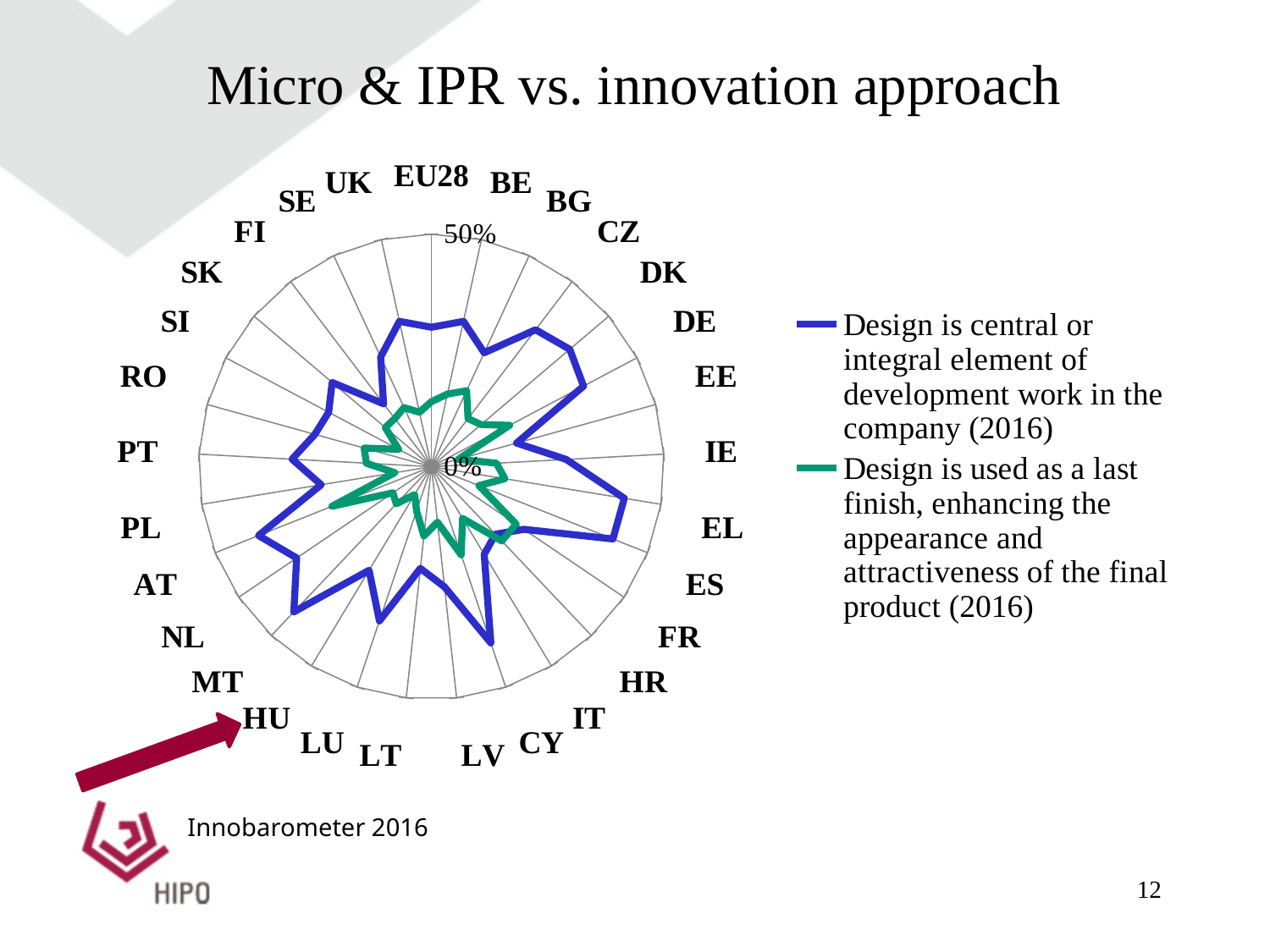
Which colour represents the series 'Design is central or integral element of development work in the company (2016)'? Blue For EU28, which series has the larger value: 'Design is central or integral element of development work in the company (2016)' or 'Design is used as a last finish, enhancing the appearance and attractiveness of the final product (2016)'? Design is central or integral element of development work in the company (2016) Is the value for EL in the series 'Design is used as a last finish, enhancing the appearance and attractiveness of the final product (2016)' greater or less than 50%? less Is the value for EU28 in the series 'Design is central or integral element of development work in the company (2016)' greater or less than 50%? less What is the maximum value shown on the chart's radial axis? 50% How many series does the chart's legend list? 2 What is the title of the slide containing the chart? Micro & IPR vs. innovation approach What kind of chart is shown on the slide? Radar chart For EL, which series has the larger value: 'Design is central or integral element of development work in the company (2016)' or 'Design is used as a last finish, enhancing the appearance and attractiveness of the final product (2016)'? Design is central or integral element of development work in the company (2016) How many categories (countries/regions) are plotted around the radar chart? 29